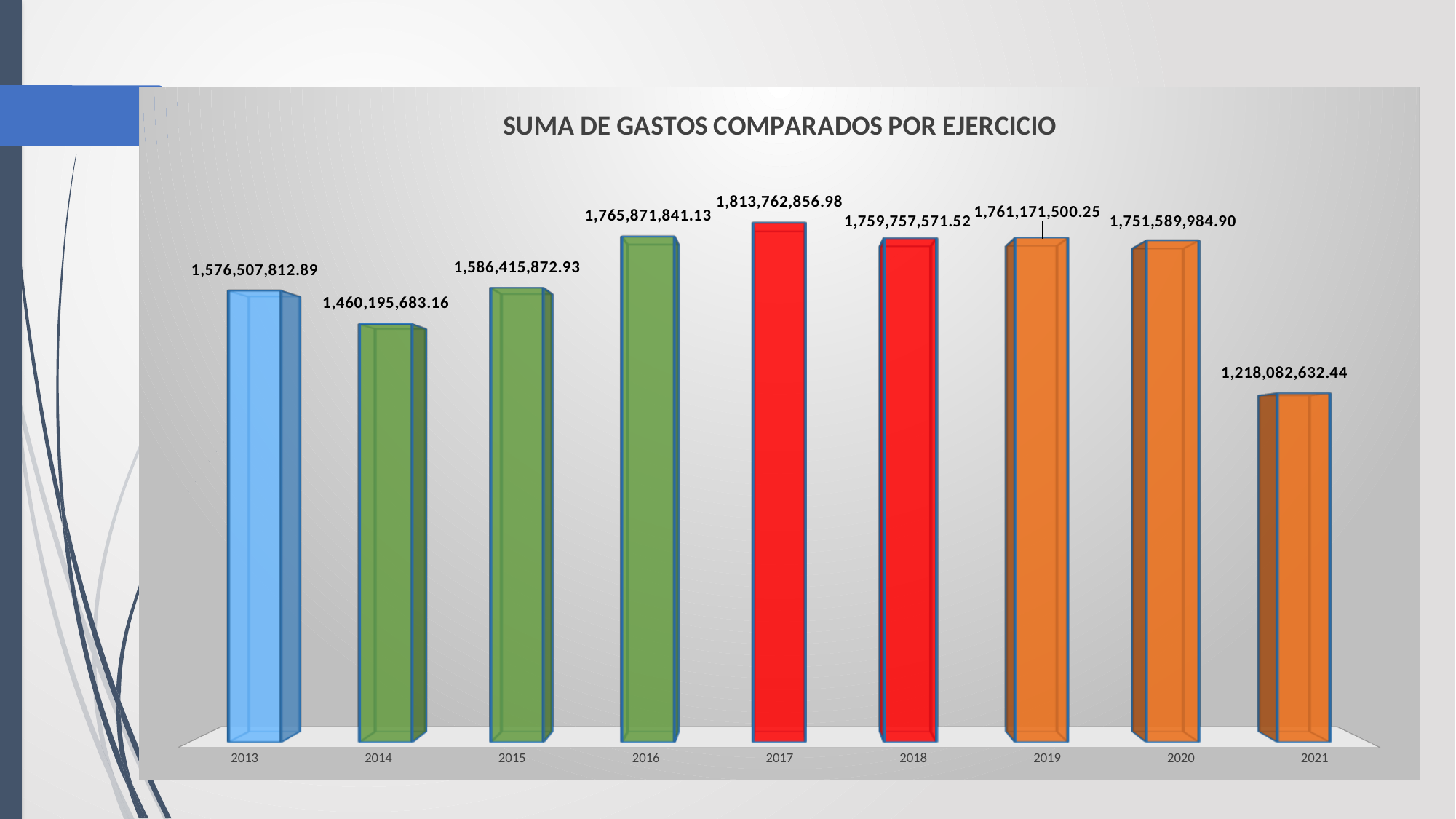
What is the value for 2017? 1,813,762,856.98 Which year has the lowest value? 2021 How many years are shown on the x axis? 9 Which year has the highest value? 2017 What is the difference between the values for 2013 and 2014? 116,312,129.73 What is the value for 2021? 1,218,082,632.44 What is the value for 2014? 1,460,195,683.16 Do the values rise or fall from 2020 to 2021? Fall What is the difference between the values for 2017 and 2021? 595,680,224.54 What kind of chart is this? Bar chart Which is larger, the value for 2015 or the value for 2020? 2020 What is the title of the chart? SUMA DE GASTOS COMPARADOS POR EJERCICIO